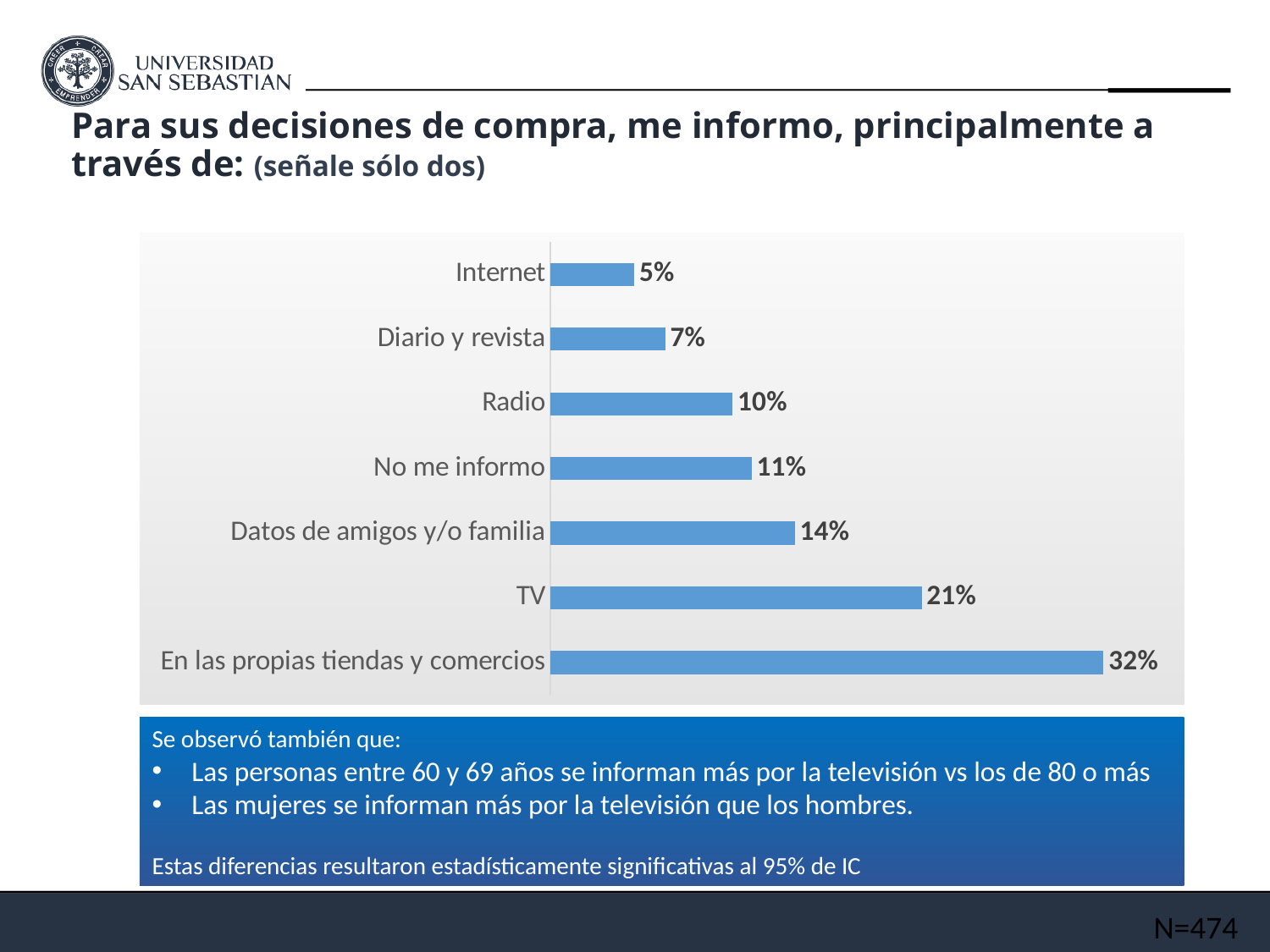
What is the sample size (N) shown on the slide? N=474 What is the difference between the values for En las propias tiendas y comercios and TV? 11% Which category has the highest value? En las propias tiendas y comercios Which is larger, the value for Internet or the value for Diario y revista? Diario y revista What is the value for Radio? 10% What kind of chart is shown on the slide? Bar chart What is the difference between the values for No me informo and Diario y revista? 4% What is the value for Datos de amigos y/o familia? 14% Which category has the lowest value? Internet How many categories are shown in the chart? 7 Which is larger, the value for Radio or the value for Datos de amigos y/o familia? Datos de amigos y/o familia What is the value for TV? 21%